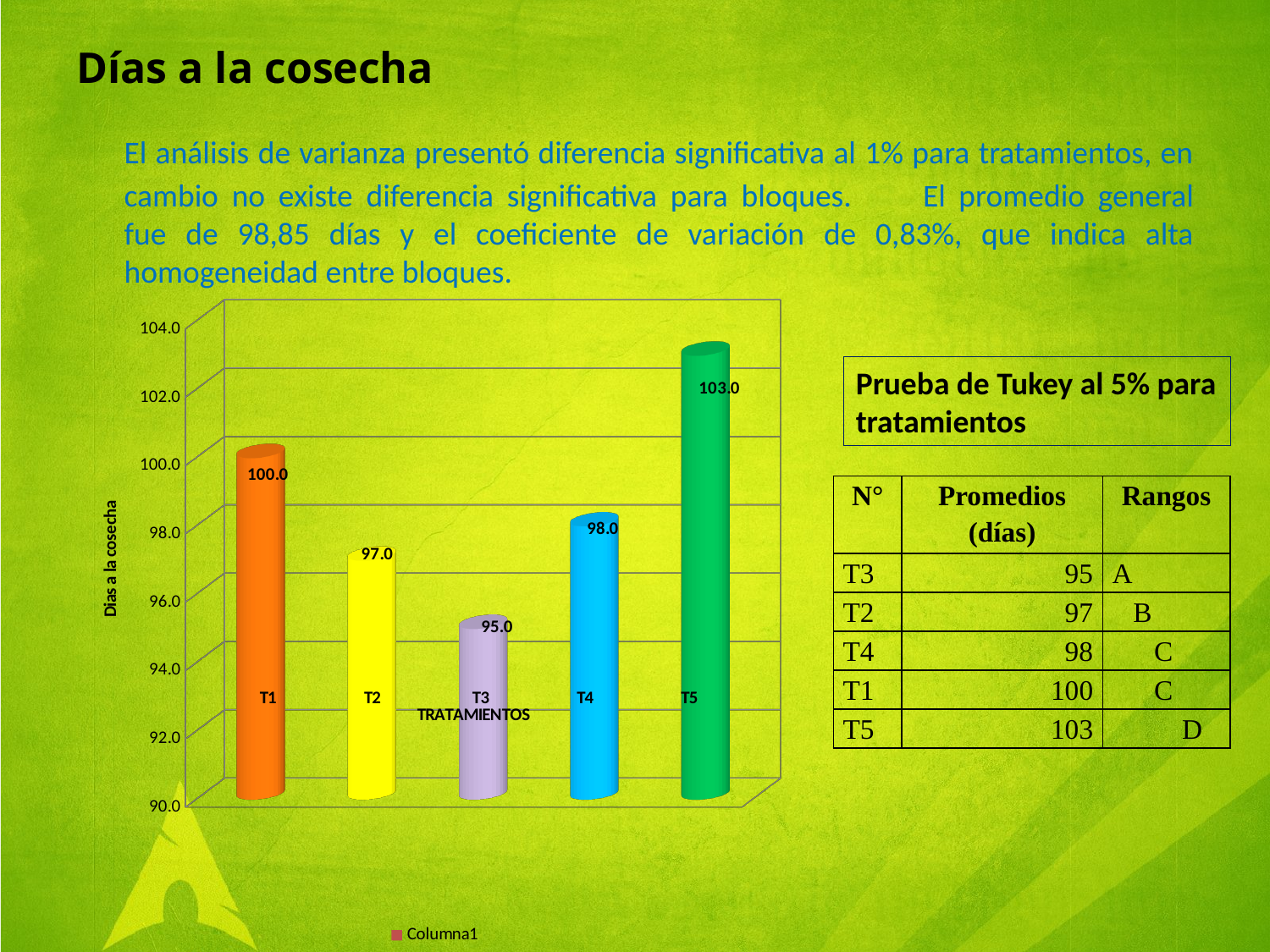
What is the value for T5 in the chart? 103.0 What is the value for T3 in the chart? 95.0 Which treatment has the highest value in the chart? T5 Which is larger, the value for T2 or the value for T4? T4 What is the label of the x axis of the chart? TRATAMIENTOS Is the value for T1 greater or less than 98.0? greater Which treatment has the lowest value in the chart? T3 What kind of chart is shown on the slide? bar chart What is the difference between the values for T5 and T3? 8.0 What is the label of the y axis of the chart? Días a la cosecha What is the value for T1 in the chart? 100.0 How many treatments are shown on the x axis of the chart? 5